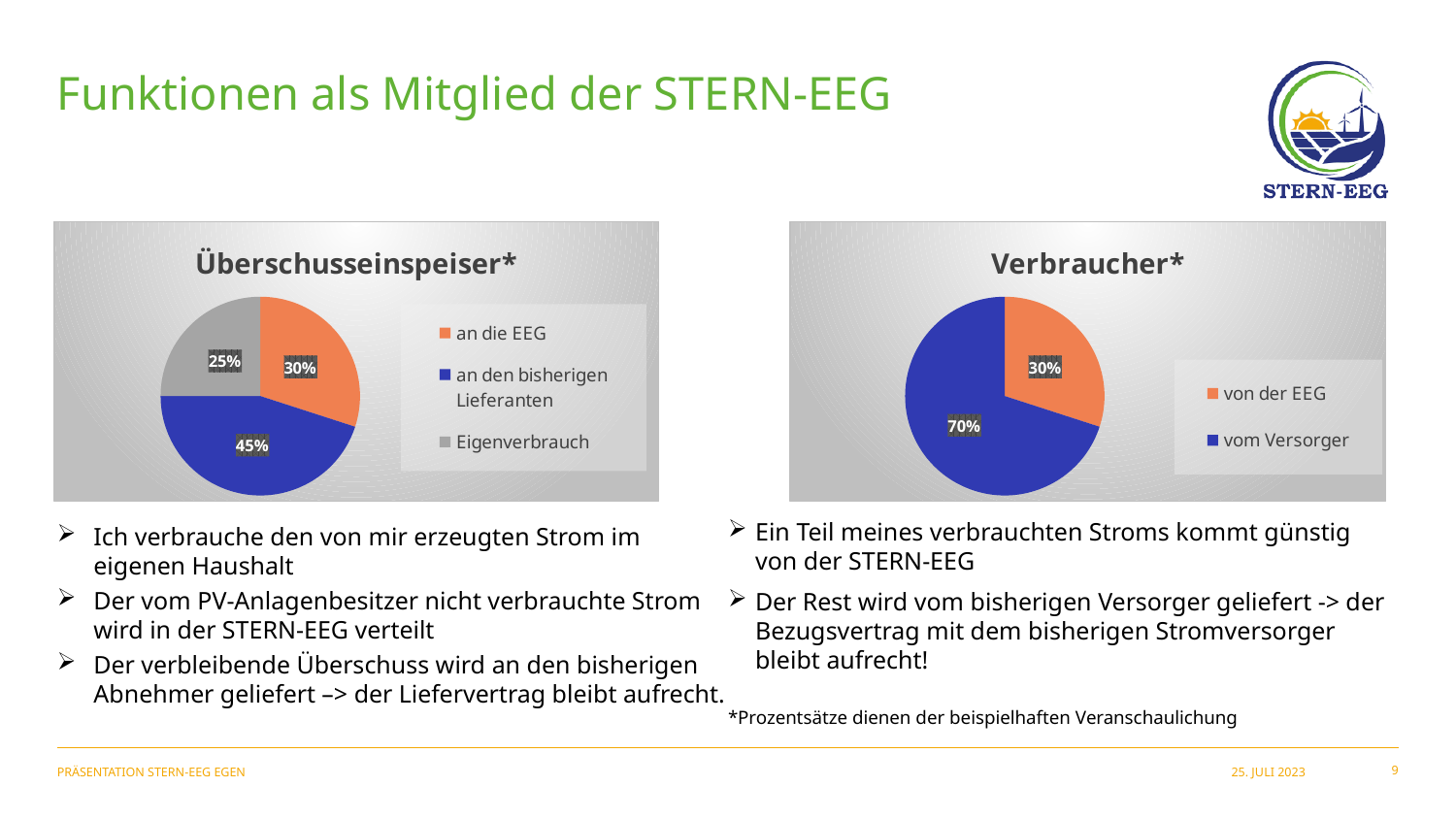
In the 'Überschusseinspeiser*' chart, which category has the largest slice? an den bisherigen Lieferanten In the 'Überschusseinspeiser*' chart, what share goes to 'an den bisherigen Lieferanten'? 45% In the 'Überschusseinspeiser*' chart, what is the difference between the 'an den bisherigen Lieferanten' and 'Eigenverbrauch' shares? 20% In the 'Überschusseinspeiser*' chart, what share goes to 'an die EEG'? 30% In the 'Überschusseinspeiser*' chart, what share is 'Eigenverbrauch'? 25% In the 'Überschusseinspeiser*' chart, which category has the smallest slice? Eigenverbrauch In the 'Verbraucher*' chart, what share comes 'von der EEG'? 30% In the 'Verbraucher*' chart, which is larger: 'von der EEG' or 'vom Versorger'? vom Versorger What type of chart is the 'Verbraucher*' chart? Pie chart How many slices does the 'Überschusseinspeiser*' pie chart have? 3 In the 'Verbraucher*' chart, what share comes 'vom Versorger'? 70% In the 'Verbraucher*' chart, what colour is the 'vom Versorger' slice? Blue